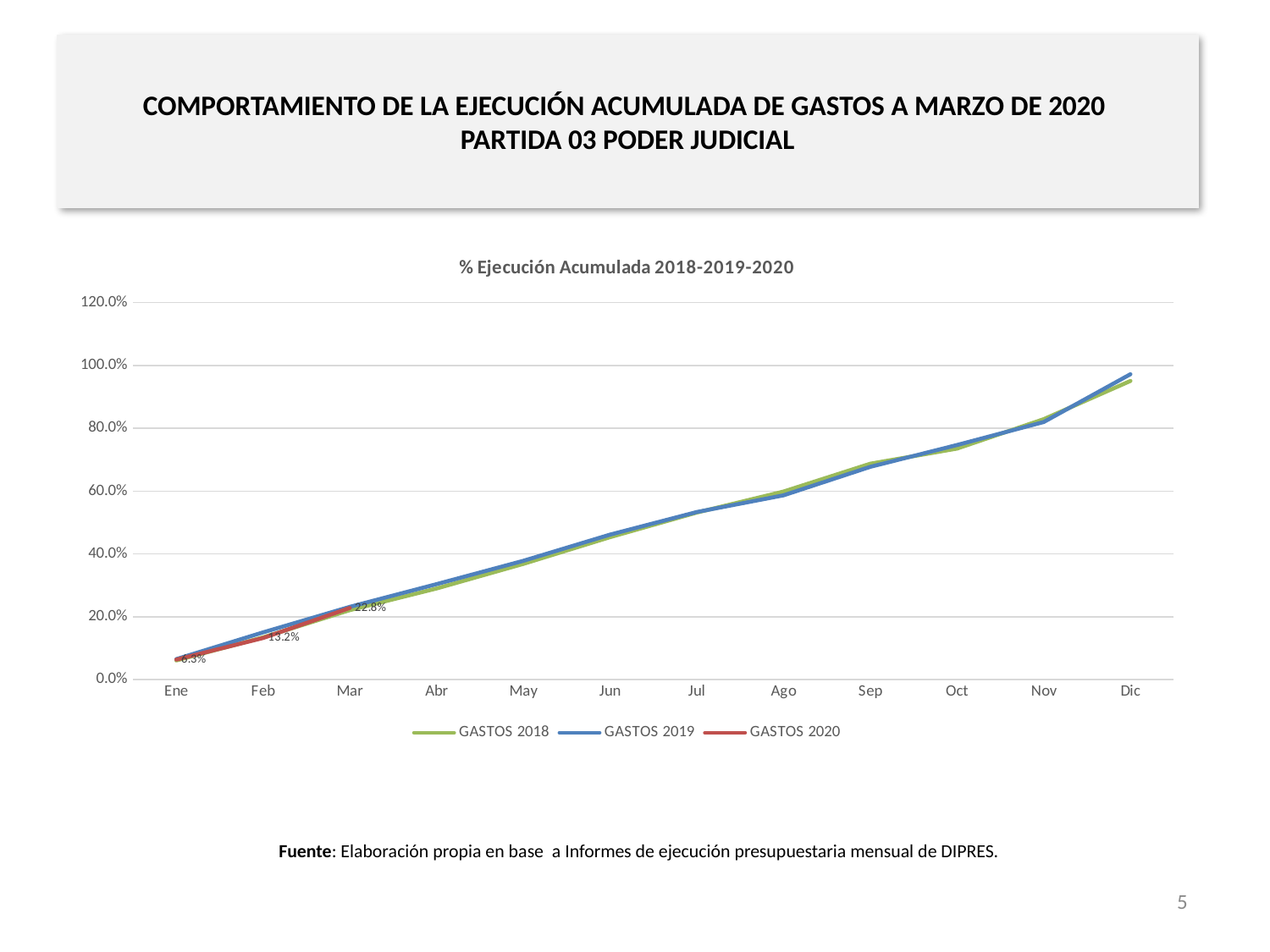
What is the value for GASTOS 2020 in Mar? 22.8% How many months are shown on the x axis? 12 Which month has the highest value for GASTOS 2020? Mar What is the value for GASTOS 2020 in Ene? 6.3% Do the values for GASTOS 2019 rise or fall from Ene to Dic? Rise What is the difference between the GASTOS 2020 values for Feb and Ene? 6.9% What kind of chart is shown on the slide? Line chart Is the value for GASTOS 2019 in Dic greater or less than 80.0%? greater How many series does the legend list? 3 What is the value for GASTOS 2020 in Feb? 13.2% What is the difference between the GASTOS 2020 values for Mar and Feb? 9.6% What is the title of the chart? % Ejecución Acumulada 2018-2019-2020